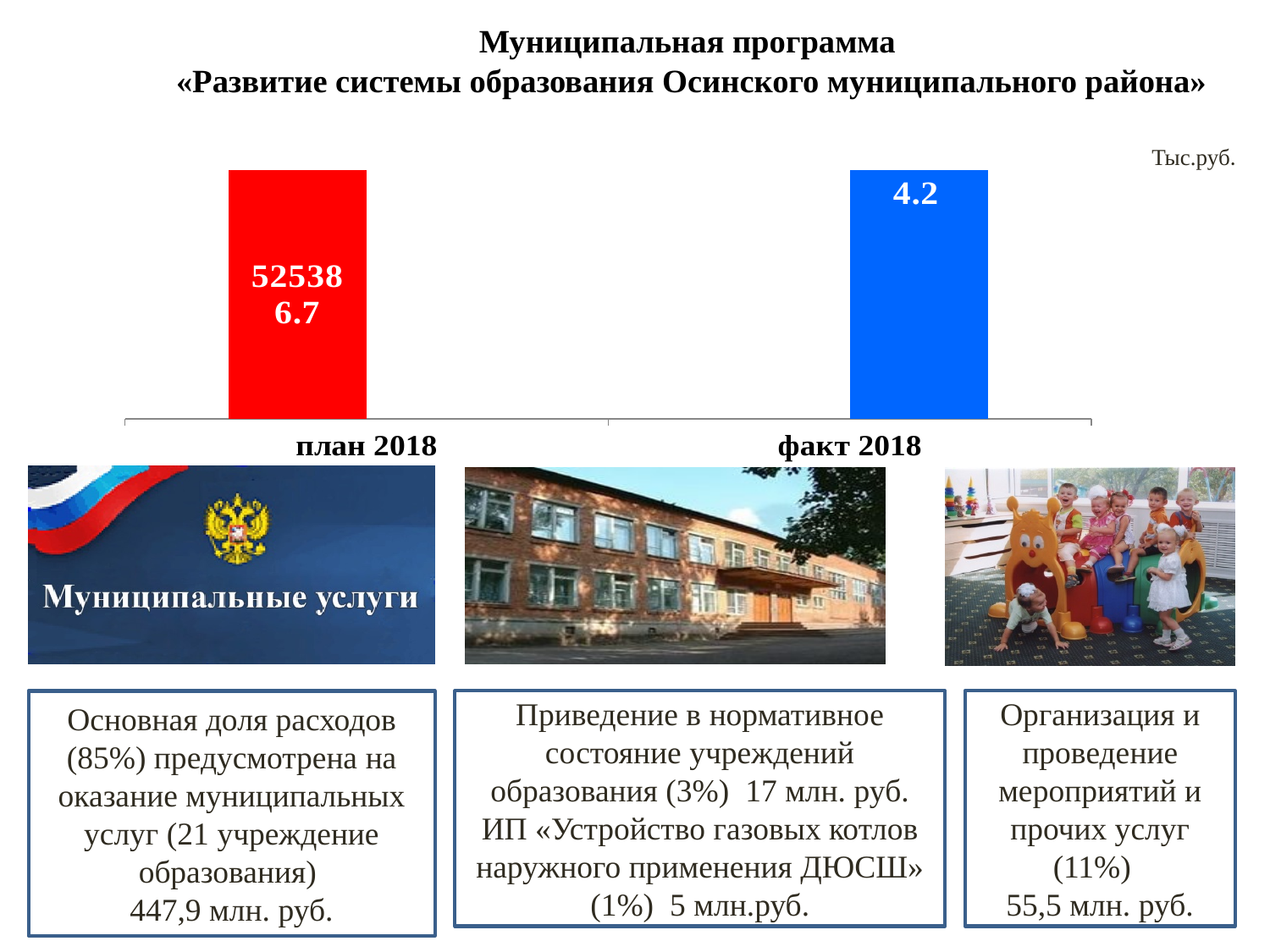
What colour is the bar for план 2018? red What unit is indicated for the values on the chart? Тыс.руб. What are the two categories shown on the x axis of the chart? план 2018 and факт 2018 How many categories are plotted on the chart? 2 What kind of chart is shown on the slide? bar chart What value is printed on the bar for план 2018? 525386.7 What value is printed on the bar for факт 2018? 4.2